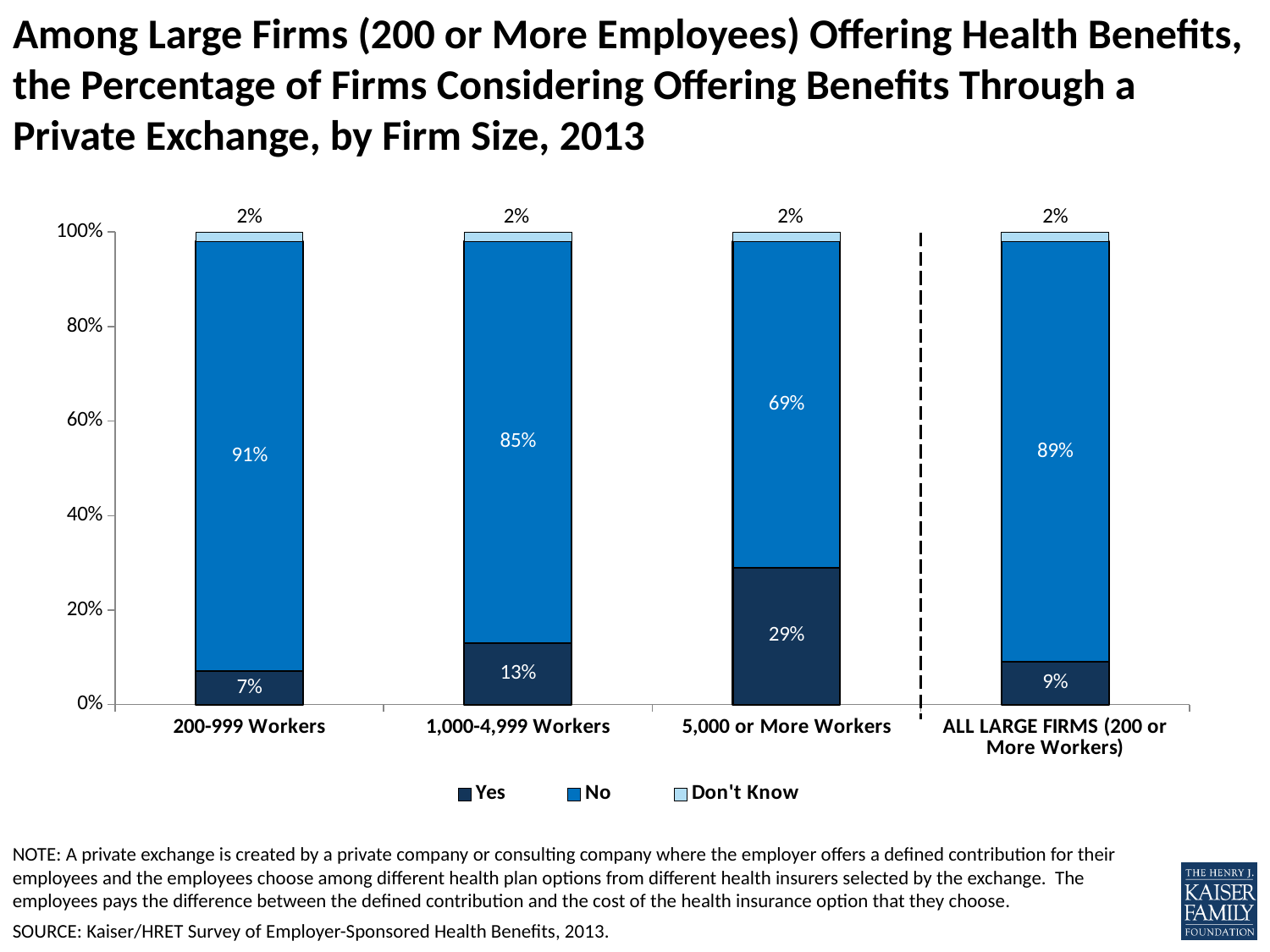
What percentage of firms with 200-999 workers answered No? 91% What is the difference between the Yes percentage for firms with 5,000 or more workers and firms with 1,000-4,999 workers? 16% What kind of chart is shown on the slide? Stacked bar chart What are the three legend entries? Yes, No, Don't Know How many series does the legend list? 3 Which firm size category has the lowest Yes percentage? 200-999 Workers Which is larger: the No percentage for 1,000-4,999 workers or for all large firms? All large firms (89%) What percentage of firms with 1,000-4,999 workers answered Don't Know? 2% How many firm size categories are shown on the x axis? 4 What percentage of firms with 5,000 or more workers answered Yes? 29% What percentage of all large firms (200 or more workers) answered Yes? 9% Which firm size category has the highest Yes percentage? 5,000 or More Workers